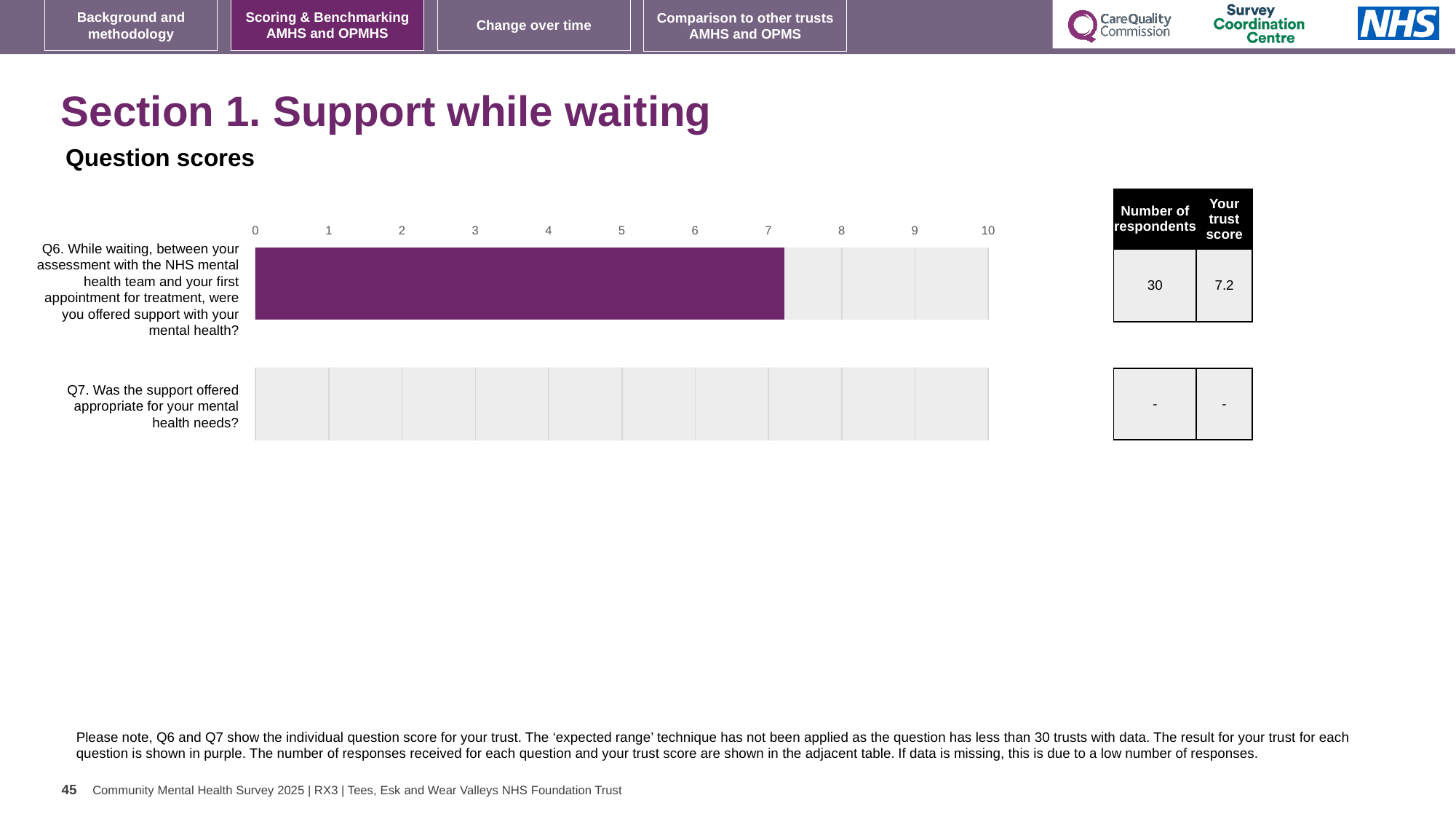
How many respondents answered Q6 according to the table? 30 Is the value of the bar for Q6 greater or less than 8? less Which of the two questions, Q6 or Q7, has the higher plotted score? Q6 Which question has a purple bar plotted on the chart? Q6 How many questions (categories) are listed on the chart's vertical axis? 2 What kind of chart is shown on the slide? bar chart What is shown in the table for the number of respondents and trust score for Q7? - Is the value of the bar for Q6 greater or less than 7? greater What is the trust score for Q6 shown in the adjacent table? 7.2 What is the maximum value shown on the chart's horizontal axis? 10